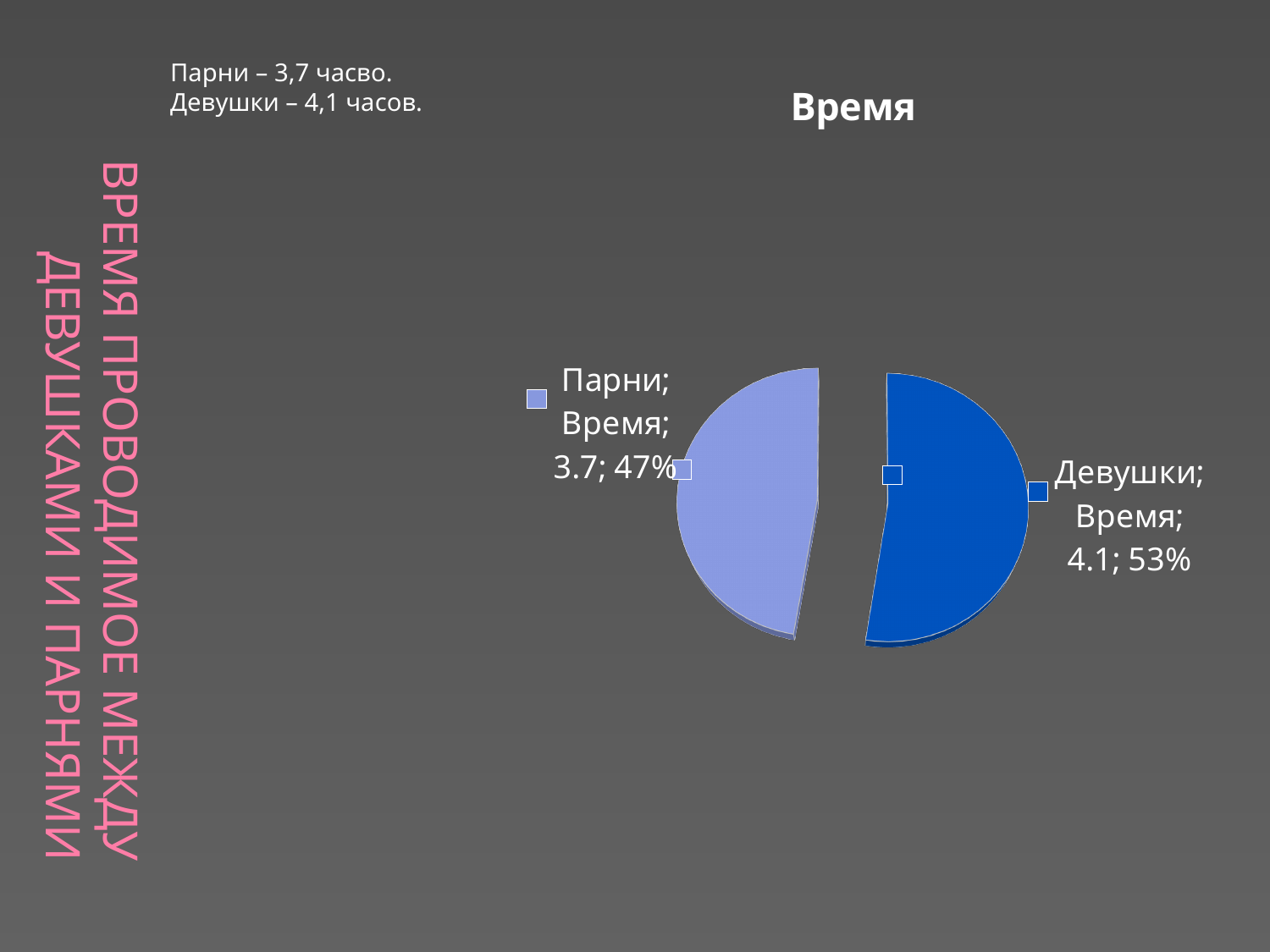
What kind of chart is shown on the slide? pie chart Which category has the largest slice in the pie chart? Девушки What is the name of the data series shown in the pie chart? Время Which category has the smallest slice in the pie chart? Парни What is the title of the chart? Время What is the value for Девушки in the pie chart? 4.1 What is the value for Парни in the pie chart? 3.7 What is the difference between the values for Девушки and Парни? 0.4 How many slices does the pie chart have? 2 What share of the pie does the Девушки slice represent? 53% Which is larger, the value for Парни or the value for Девушки? Девушки What share of the pie does the Парни slice represent? 47%